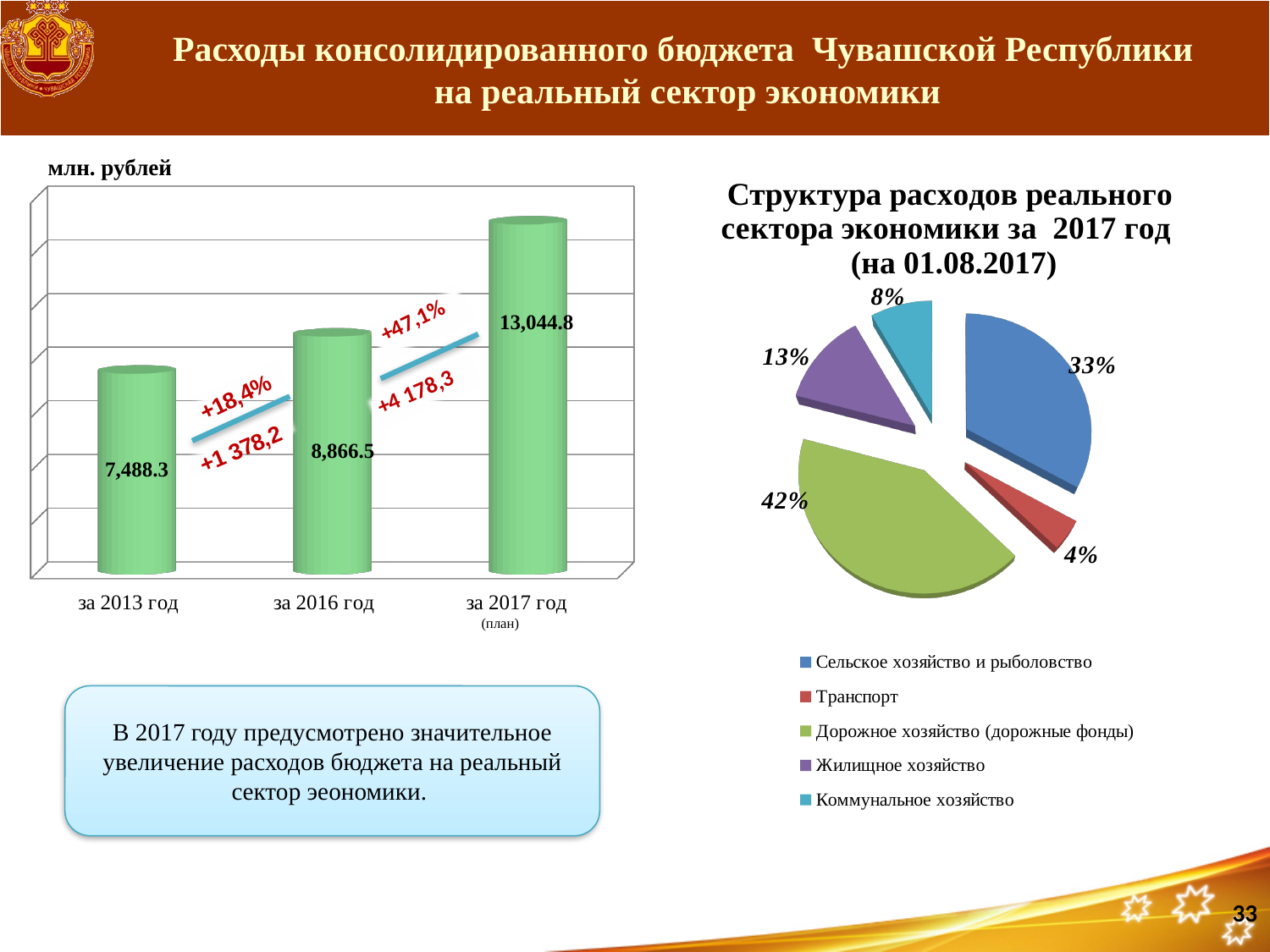
On the pie chart 'Структура расходов реального сектора экономики за 2017 год', which category has the smallest share? Транспорт On the pie chart 'Структура расходов реального сектора экономики за 2017 год', which is larger: Жилищное хозяйство or Коммунальное хозяйство? Жилищное хозяйство On the left bar chart, what is the difference between the values for за 2017 год (план) and за 2013 год? 5,556.5 What type of chart is the chart on the left of the slide? bar chart On the left bar chart, how many bars are plotted? 3 How many categories does the legend of the pie chart list? 5 On the pie chart 'Структура расходов реального сектора экономики за 2017 год', what share does Дорожное хозяйство (дорожные фонды) have? 42% On the left bar chart, do the values rise or fall from left to right along the x axis? rise On the left bar chart, which category has the lowest value? за 2013 год On the left bar chart, what is the value for за 2017 год (план)? 13,044.8 On the left bar chart, what is the value for за 2016 год? 8,866.5 On the left bar chart, which category has the highest value? за 2017 год (план)